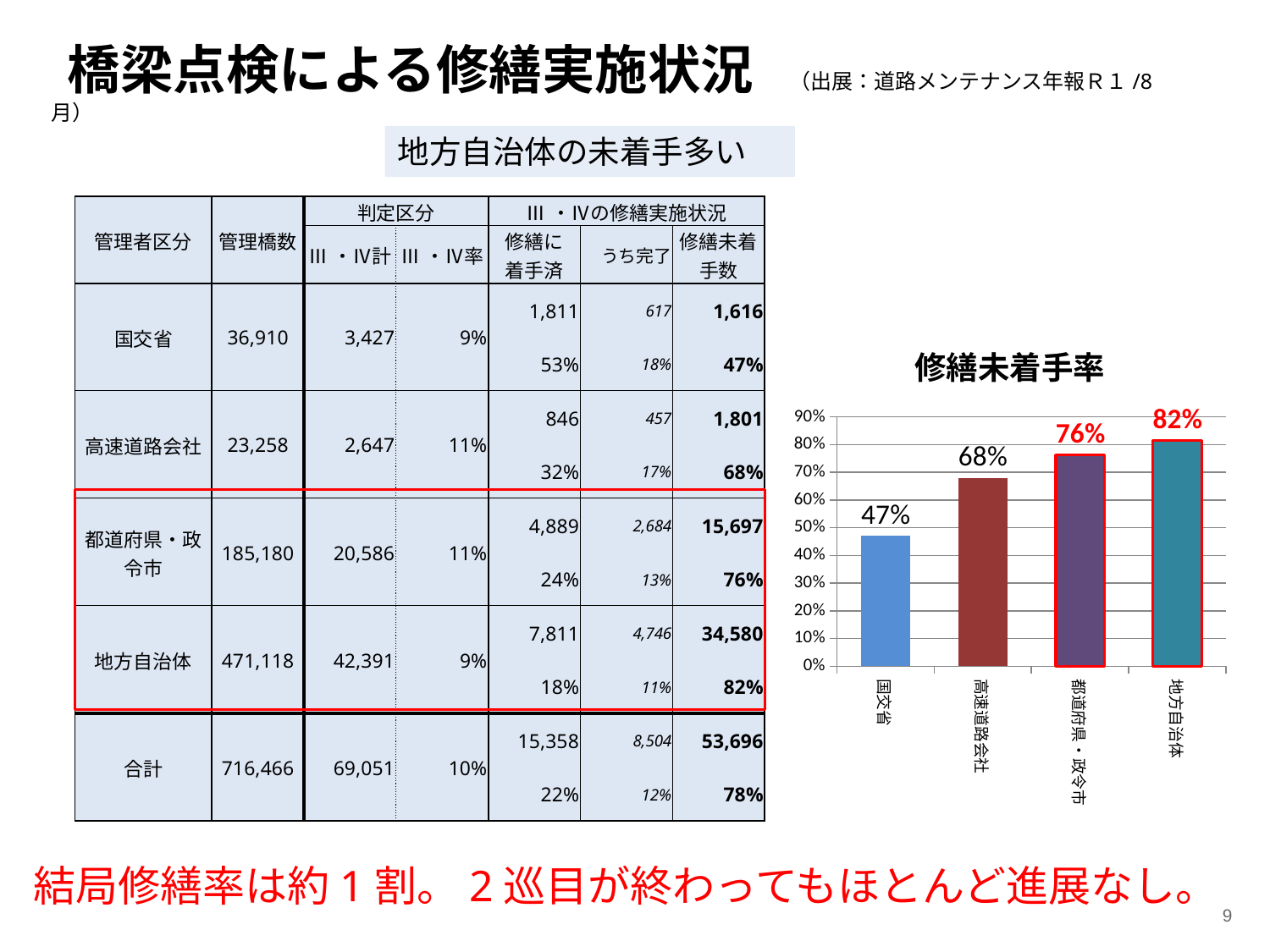
Is the value for 高速道路会社 in the 修繕未着手率 chart greater or less than 60%? greater Which category has the lowest value in the 修繕未着手率 chart? 国交省 Do the values in the 修繕未着手率 chart rise or fall from left to right along the x axis? rise What is the difference between the values for 地方自治体 and 国交省 in the 修繕未着手率 chart? 35% What kind of chart is the 修繕未着手率 chart? bar chart How many categories are shown in the 修繕未着手率 chart? 4 What is the value for 都道府県・政令市 in the 修繕未着手率 chart? 76% Which is larger in the 修繕未着手率 chart, the value for 高速道路会社 or the value for 都道府県・政令市? 都道府県・政令市 What is the value for 高速道路会社 in the 修繕未着手率 chart? 68% What is the value for 国交省 in the 修繕未着手率 chart? 47% What is the value for 地方自治体 in the 修繕未着手率 chart? 82% Which category has the highest value in the 修繕未着手率 chart? 地方自治体